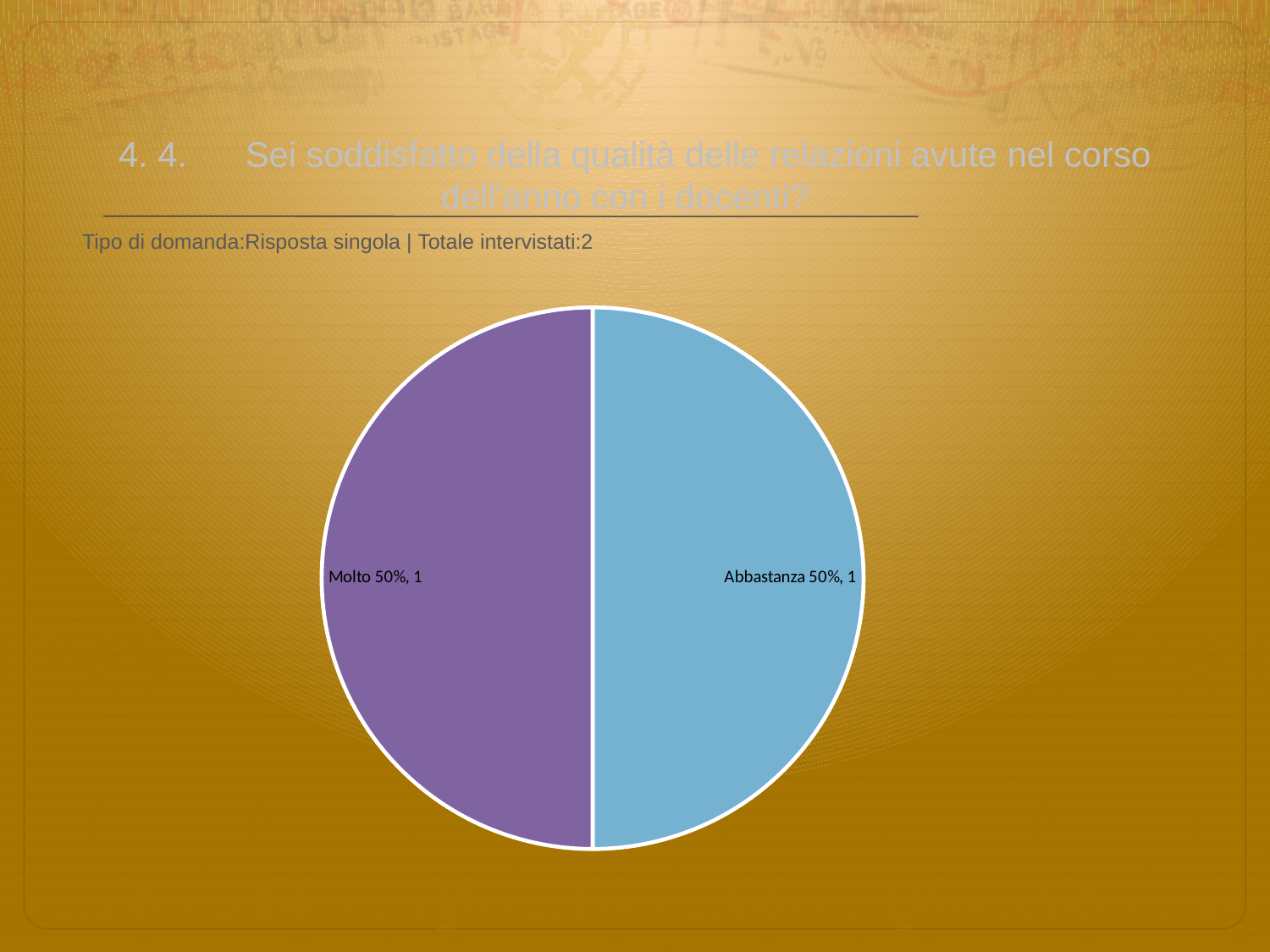
What is the total of the values for "Molto" and "Abbastanza"? 2 What is the count value shown for the "Abbastanza" slice? 1 What share of the pie does the "Abbastanza" slice represent? 50% What share of the pie does the "Molto" slice represent? 50% What is the count value shown for the "Molto" slice? 1 Which slice is shown in purple? Molto Which slice is shown in light blue? Abbastanza How many slices does the pie chart have? 2 What is the difference between the values for "Molto" and "Abbastanza"? 0 What kind of chart is shown on the slide? pie chart